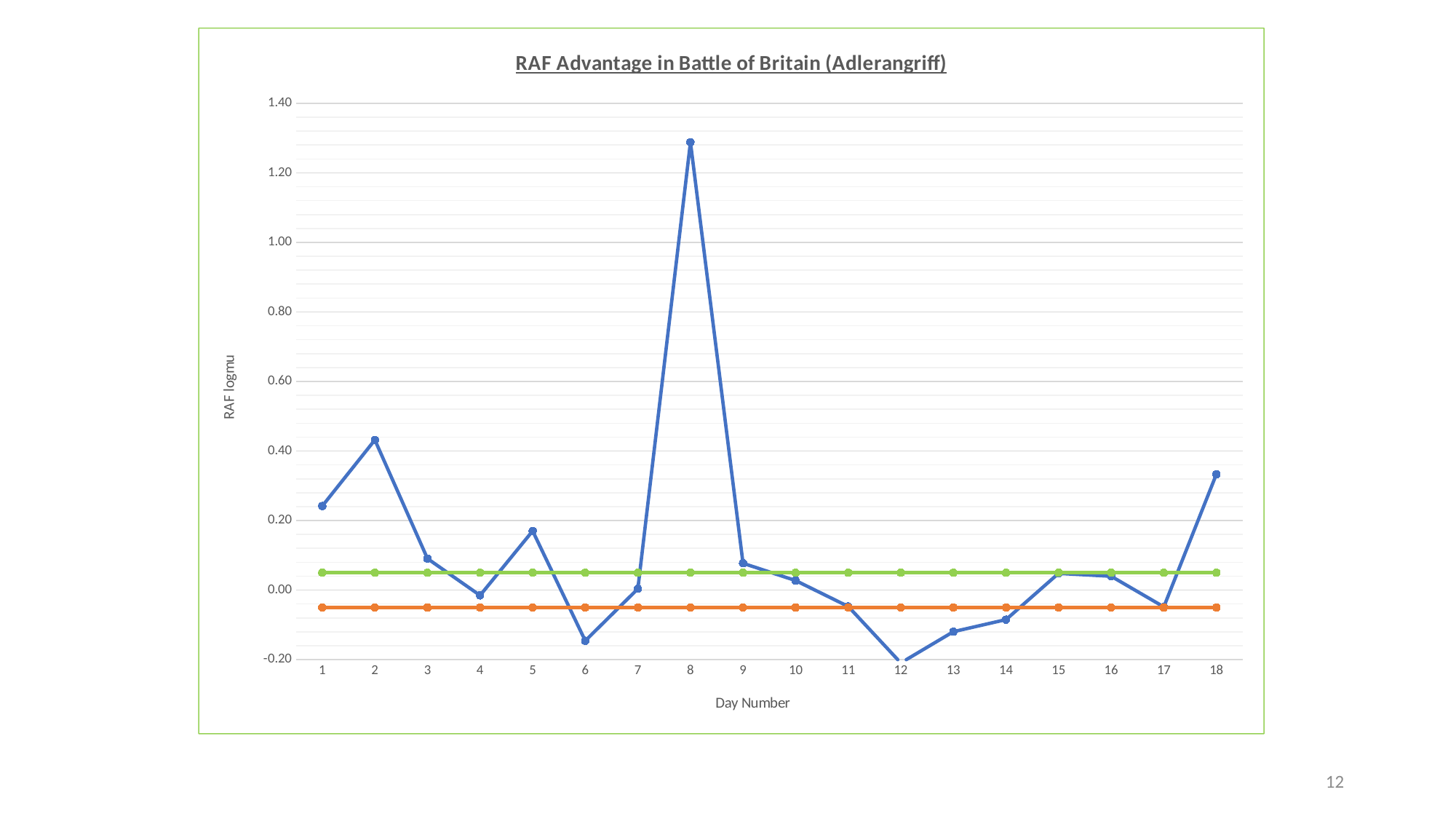
Does the blue line rise or fall from day 2 to day 4? fall On which day number does the blue line reach its lowest value? 12 Which has the larger value on the blue line, day 2 or day 18? day 2 What is the label of the x axis? Day Number Is the value of the blue line for day 8 greater or less than 1.20? greater What kind of chart is shown on the slide? line chart Is the value of the blue line for day 6 greater or less than 0.00? less Is the value of the blue line for day 18 greater or less than 0.20? greater On which day number does the blue line reach its highest value? 8 What is the title of the chart? RAF Advantage in Battle of Britain (Adlerangriff) How many day numbers are shown along the x axis? 18 How many lines are plotted on the chart? 3